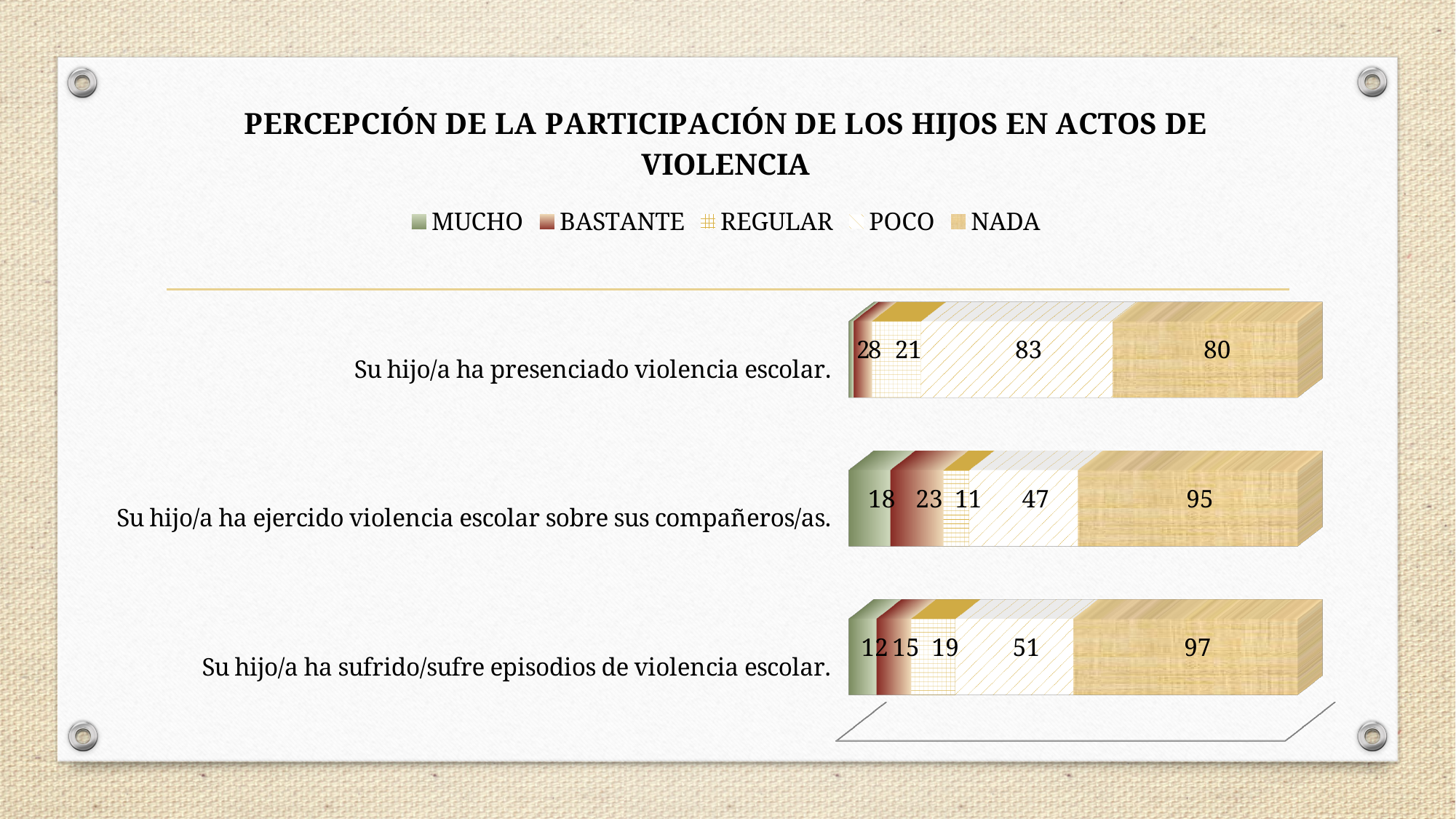
What is the difference between the NADA values for "Su hijo/a ha sufrido/sufre episodios de violencia escolar." and "Su hijo/a ha ejercido violencia escolar sobre sus compañeros/as."? 2 How many categories (statements) are plotted in the chart? 3 What is the total of the stacked bar for "Su hijo/a ha ejercido violencia escolar sobre sus compañeros/as."? 194 Which has the larger POCO value: "Su hijo/a ha ejercido violencia escolar sobre sus compañeros/as." or "Su hijo/a ha sufrido/sufre episodios de violencia escolar."? Su hijo/a ha sufrido/sufre episodios de violencia escolar. What is the MUCHO value for "Su hijo/a ha sufrido/sufre episodios de violencia escolar."? 12 How many series does the legend list? 5 What is the REGULAR value for "Su hijo/a ha ejercido violencia escolar sobre sus compañeros/as."? 11 Which series is listed first in the legend? MUCHO What is the POCO value for "Su hijo/a ha presenciado violencia escolar."? 83 What kind of chart is shown on the slide? Stacked bar chart Which statement has the highest NADA value? Su hijo/a ha sufrido/sufre episodios de violencia escolar. What is the NADA value for "Su hijo/a ha ejercido violencia escolar sobre sus compañeros/as."? 95